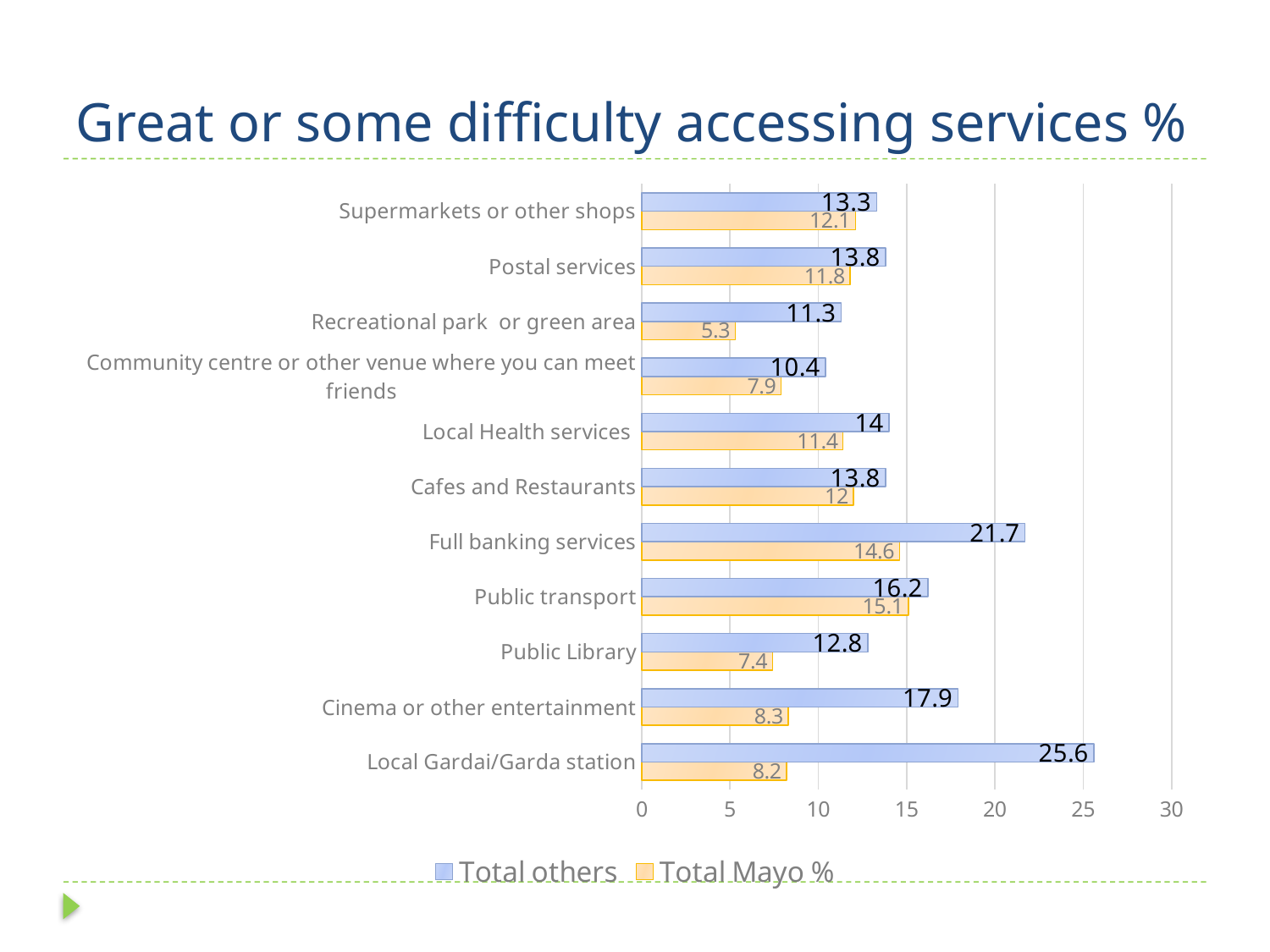
Which is larger for Public transport: Total others or Total Mayo %? Total others Is the Total others value for Full banking services greater or less than 20? greater What is the Total Mayo % value for Full banking services? 14.6 What is the Total Mayo % value for Recreational park or green area? 5.3 What kind of chart is shown on the slide? Bar chart Which category has the highest Total others value? Local Gardai/Garda station What is the difference between the Total others and Total Mayo % values for Local Gardai/Garda station? 17.4 Which category has the lowest Total Mayo % value? Recreational park or green area How many series does the legend list? 2 What is the title of the chart? Great or some difficulty accessing services % How many categories are shown on the chart? 11 What is the Total others value for Local Gardai/Garda station? 25.6